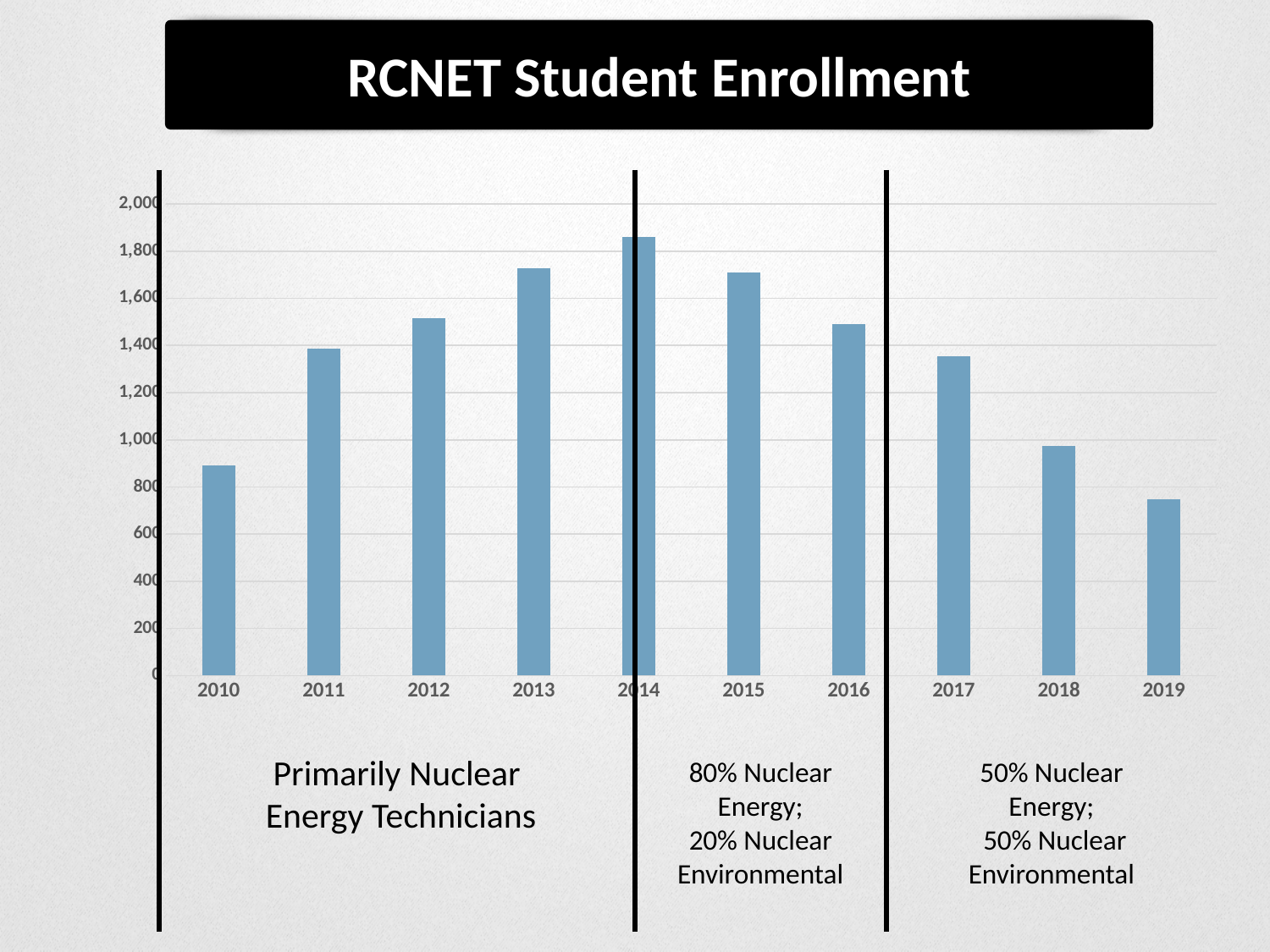
What is the title of the chart? RCNET Student Enrollment Which year has the highest enrollment? 2014 Is the value for 2013 greater or less than 1,600? greater Is the value for 2010 greater or less than 1,000? less Which year has the larger enrollment, 2012 or 2017? 2012 How does enrollment change from 2014 to 2019? It falls Which year has the lowest enrollment? 2019 Which year has the larger enrollment, 2011 or 2018? 2011 How many years are shown on the x axis of the chart? 10 What kind of chart is shown on the slide? bar chart Is the value for 2014 greater or less than 1,800? greater